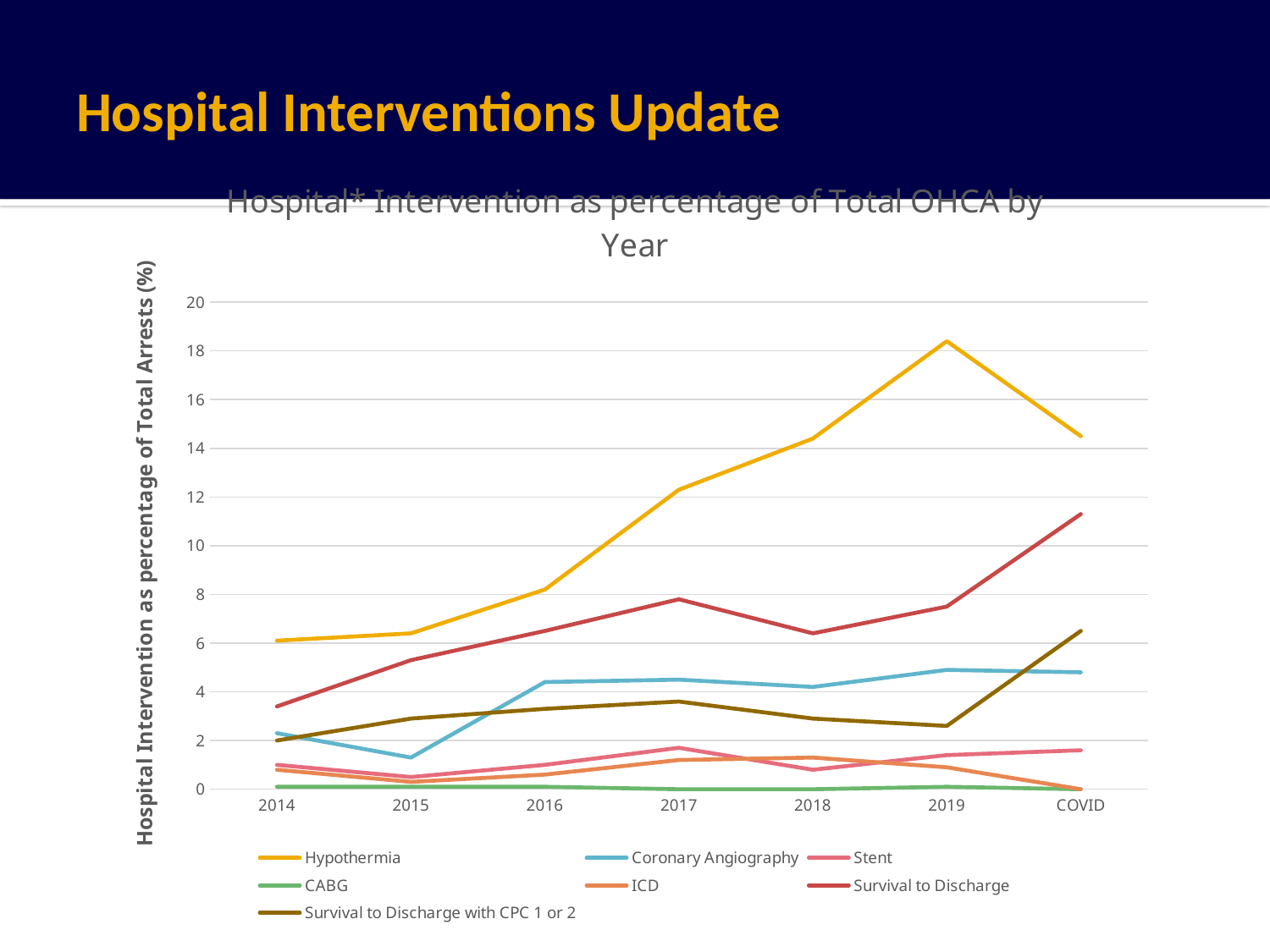
Does the Hypothermia line rise or fall from 2014 to 2019? rise What kind of chart is shown on the slide? line chart How many series does the legend list? 7 How many categories are shown on the x axis? 7 Is the value for Survival to Discharge in 2017 greater or less than 6? greater Is the value for Hypothermia in 2019 greater or less than 16? greater In 2014, which is larger: Hypothermia or Survival to Discharge? Hypothermia Which series stays lowest across the whole chart? CABG In which year does the Hypothermia line reach its highest value? 2019 At COVID, which is larger: Survival to Discharge with CPC 1 or 2, or Coronary Angiography? Survival to Discharge with CPC 1 or 2 Is the value for Survival to Discharge at COVID greater or less than 10? greater